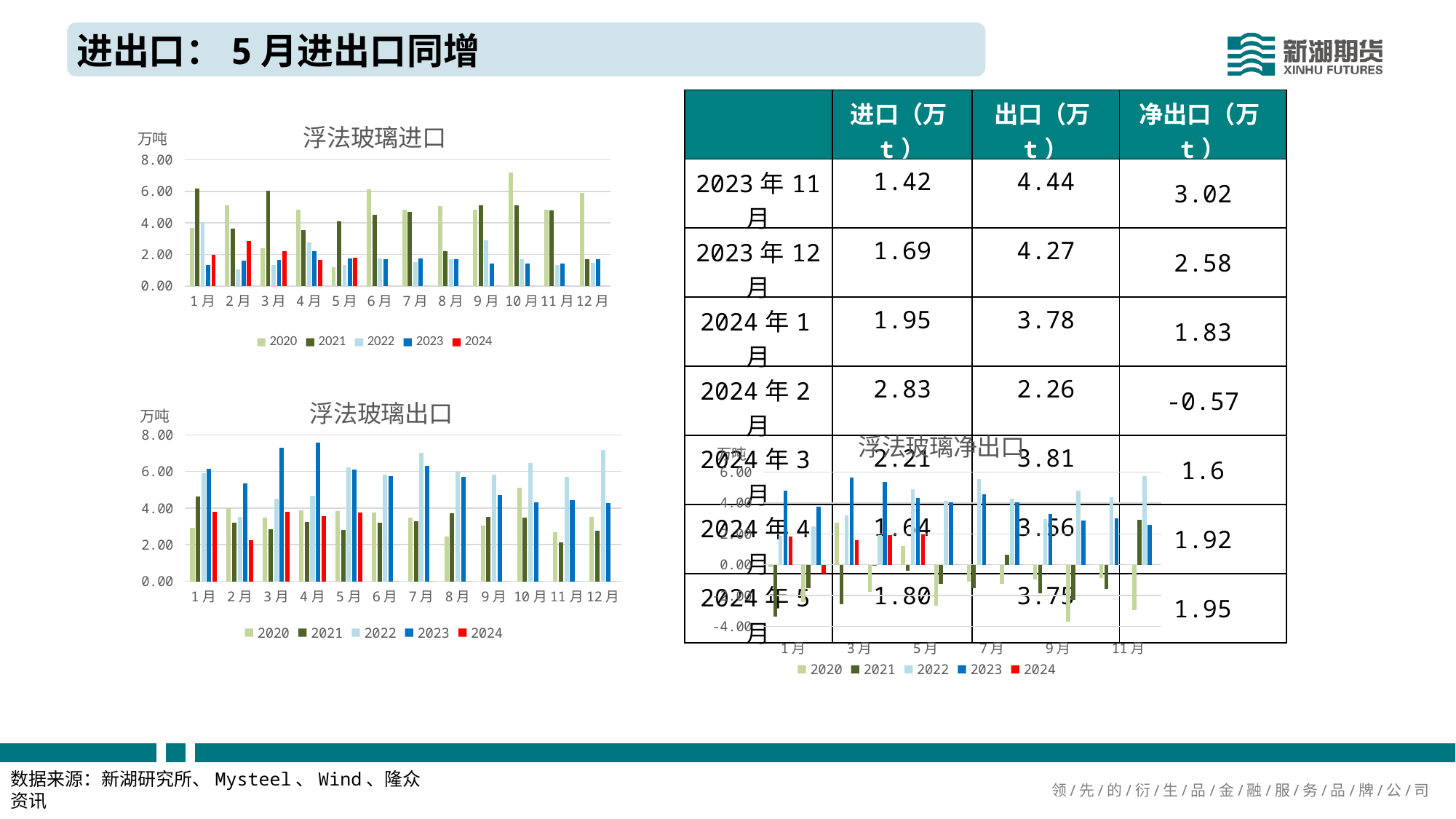
In the 浮法玻璃进口 chart, in 10月, which is larger: the 2020 value or the 2023 value? 2020 What kind of chart is the 浮法玻璃进口 chart? bar chart What unit is shown on the y axis of the 浮法玻璃出口 chart? 万吨 In the 浮法玻璃出口 chart, is the value for 2023 in 4月 greater or less than 6.00? greater In the 浮法玻璃出口 chart, in 4月, which is larger: the 2023 value or the 2024 value? 2023 In the 浮法玻璃进口 chart, is the value for 2020 in 10月 greater or less than 6.00? greater How many series does the legend of the 浮法玻璃出口 chart list? 5 In the 浮法玻璃进口 chart, which month has the tallest 2020 bar? 10月 How many month categories are shown on the x axis of the 浮法玻璃进口 chart? 12 What is the title of the chart at the bottom right of the slide? 浮法玻璃净出口 In the 浮法玻璃进口 chart, is the value for 2023 in 1月 greater or less than 2.00? less